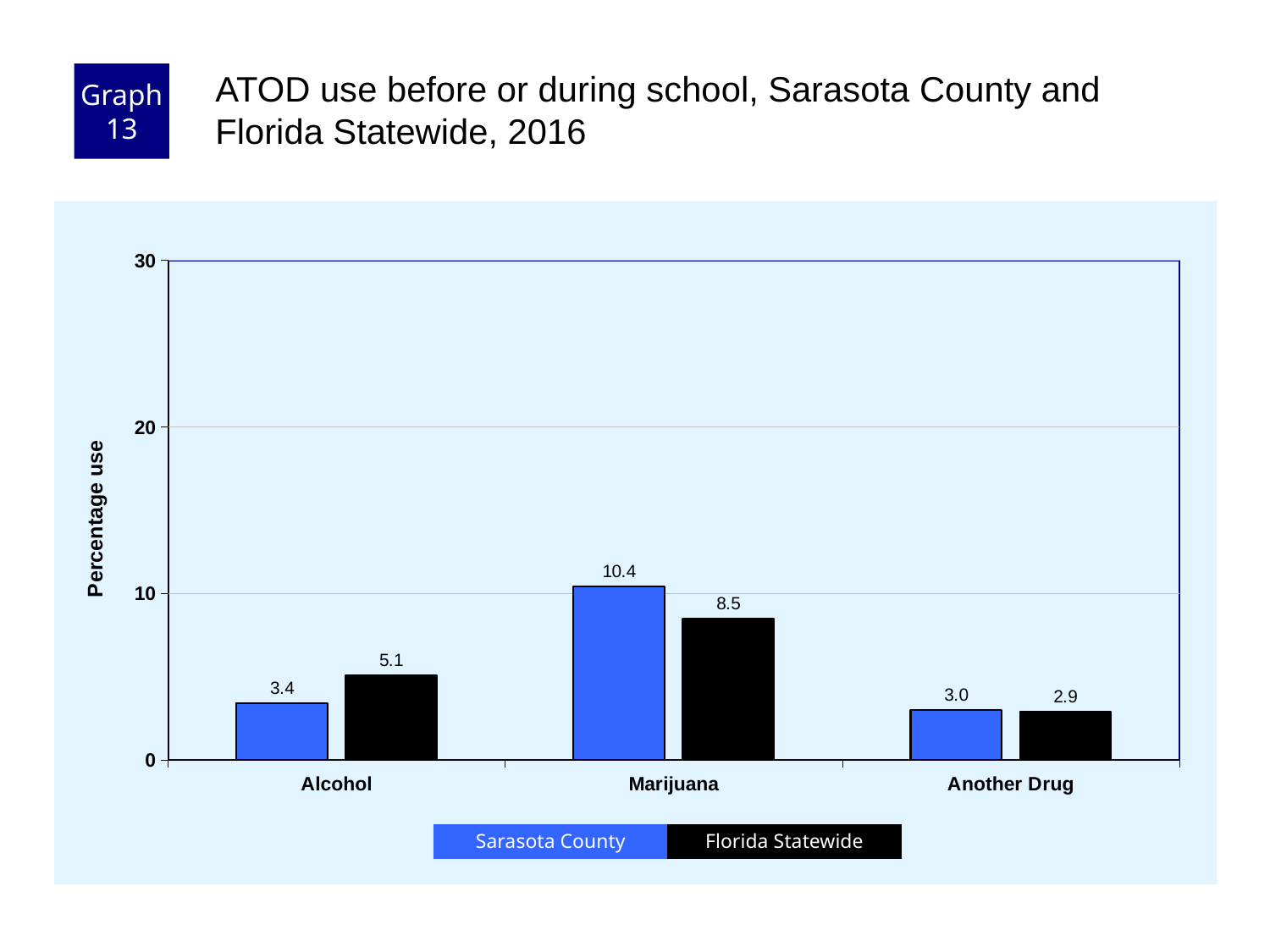
What kind of chart is shown on the slide? bar chart Which is larger for Alcohol, the Sarasota County value or the Florida Statewide value? Florida Statewide Which category has the highest Sarasota County value? Marijuana How many categories are shown on the x axis? 3 Which category has the lowest Florida Statewide value? Another Drug What is the Sarasota County value for Marijuana? 10.4 What is the difference between the Florida Statewide and Sarasota County values for Alcohol? 1.7 What is the Florida Statewide value for Alcohol? 5.1 What is the Florida Statewide value for Another Drug? 2.9 Is the Sarasota County value for Marijuana greater or less than 10? greater How many series does the legend list? 2 What is the difference between the Sarasota County and Florida Statewide values for Marijuana? 1.9